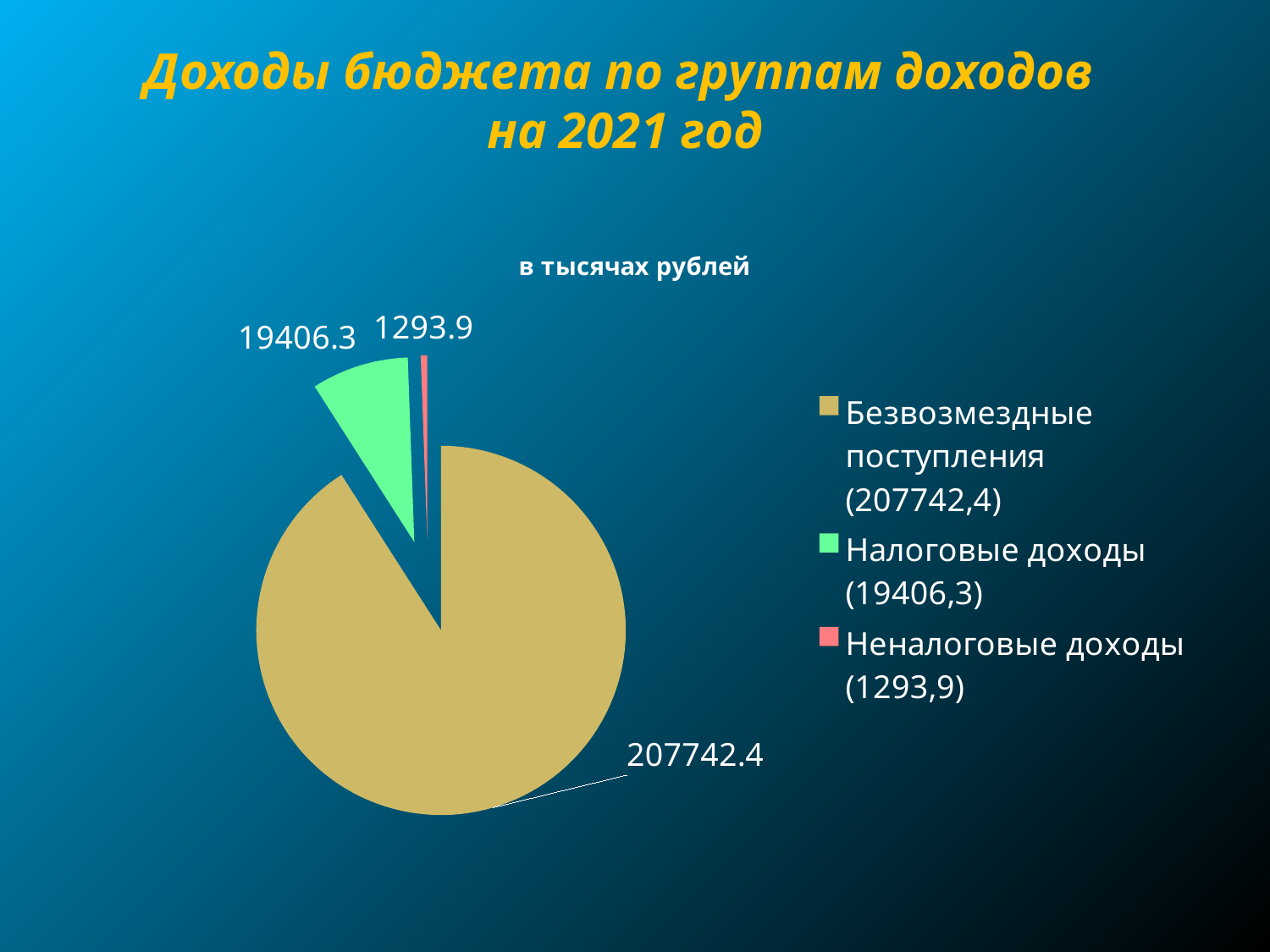
What is the difference between Налоговые доходы and Неналоговые доходы? 18112.4 How many slices does the pie chart have? 3 What unit is stated in the chart title above the pie? в тысячах рублей What is the value for Безвозмездные поступления? 207742.4 What is the difference between Безвозмездные поступления and Налоговые доходы? 188336.1 Which category has the largest slice of the pie? Безвозмездные поступления What is the value for Налоговые доходы? 19406.3 Which category has the smallest slice of the pie? Неналоговые доходы What kind of chart is shown on the slide? pie chart What share of the pie does Безвозмездные поступления represent, to one decimal place? 90.9% Which is larger, Налоговые доходы or Неналоговые доходы? Налоговые доходы What is the value for Неналоговые доходы? 1293.9